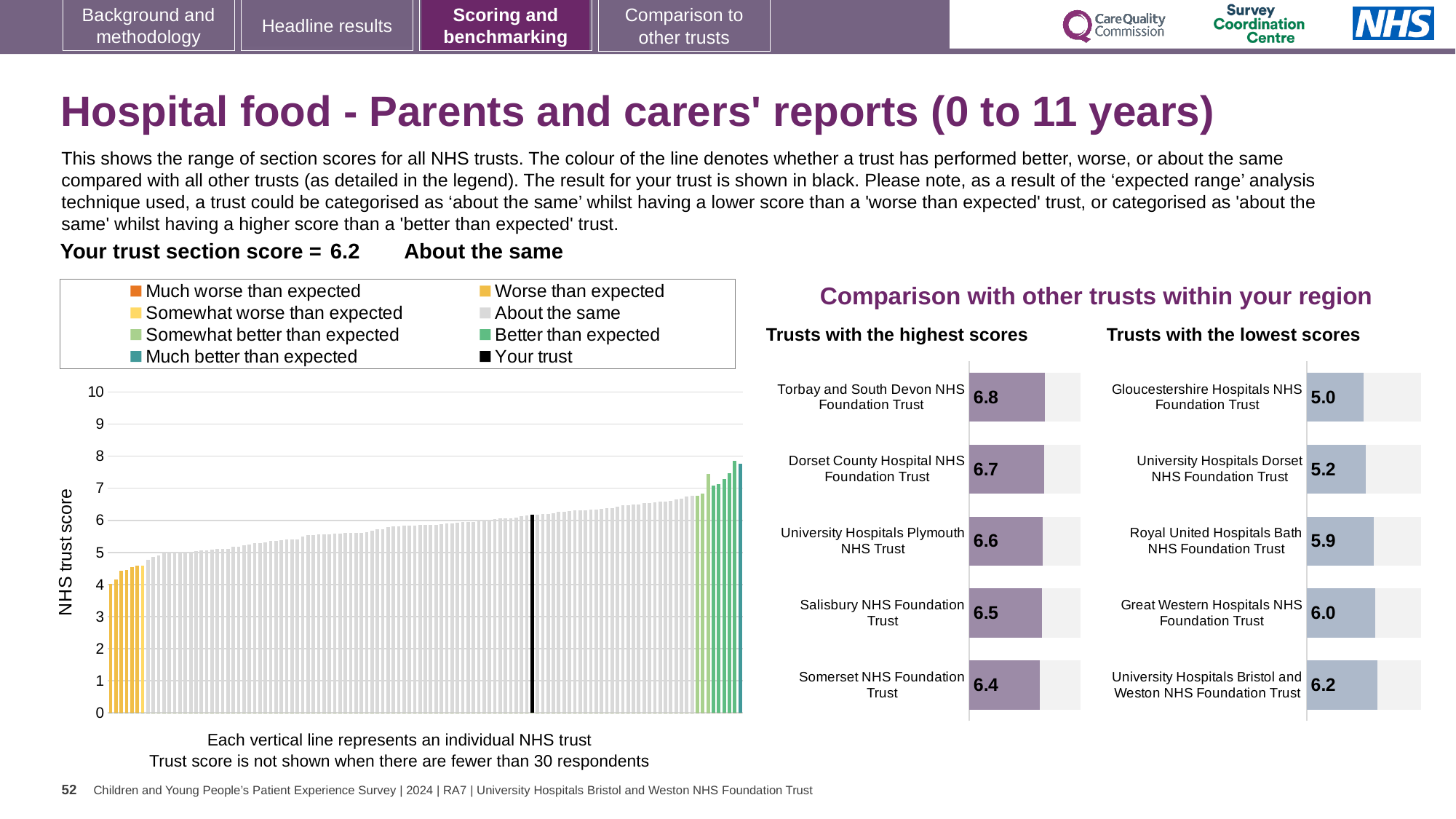
Which has the higher score: Salisbury NHS Foundation Trust in the 'highest scores' chart or Great Western Hospitals NHS Foundation Trust in the 'lowest scores' chart? Salisbury NHS Foundation Trust In the 'Trusts with the lowest scores' chart, how much higher is the score of University Hospitals Bristol and Weston NHS Foundation Trust than that of Gloucestershire Hospitals NHS Foundation Trust? 1.2 In the 'Trusts with the highest scores' chart, what is the score for Torbay and South Devon NHS Foundation Trust? 6.8 How many entries does the legend of the large chart on the left list? 8 In the large chart on the left, do the trust scores rise or fall from left to right? Rise In the 'Trusts with the highest scores' chart, which trust has the highest score? Torbay and South Devon NHS Foundation Trust What kind of chart is the large chart on the left showing NHS trust scores? Bar chart In the 'Trusts with the lowest scores' chart, what is the score for Royal United Hospitals Bath NHS Foundation Trust? 5.9 In the 'Trusts with the lowest scores' chart, what is the score for Gloucestershire Hospitals NHS Foundation Trust? 5.0 In the 'Trusts with the lowest scores' chart, which trust has the lowest score? Gloucestershire Hospitals NHS Foundation Trust In the 'Trusts with the highest scores' chart, what is the difference between the scores of Torbay and South Devon NHS Foundation Trust and Somerset NHS Foundation Trust? 0.4 How many trusts are shown in the 'Trusts with the highest scores' chart? 5